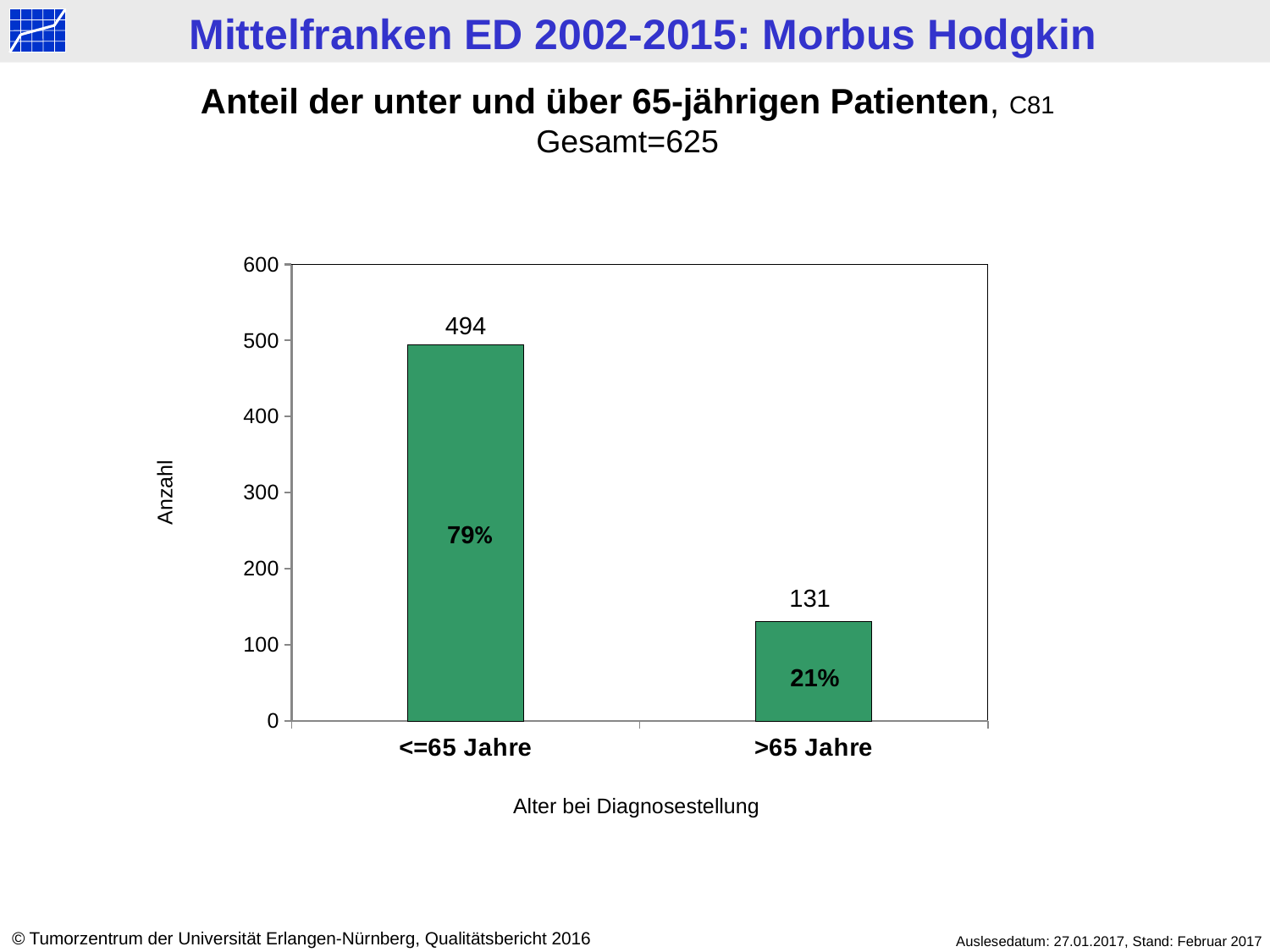
Which category has the highest value? <=65 Jahre Which is larger, the value for "<=65 Jahre" or for ">65 Jahre"? <=65 Jahre What is the value for the ">65 Jahre" category? 131 What is the value for the "<=65 Jahre" category? 494 What percentage is shown inside the "<=65 Jahre" bar? 79% Which category has the lowest value? >65 Jahre Is the value for ">65 Jahre" greater or less than 200? less What is the label of the y axis? Anzahl How many categories are shown on the x axis? 2 What percentage is shown inside the ">65 Jahre" bar? 21% What is the difference between the values for "<=65 Jahre" and ">65 Jahre"? 363 What kind of chart is shown on the slide? bar chart